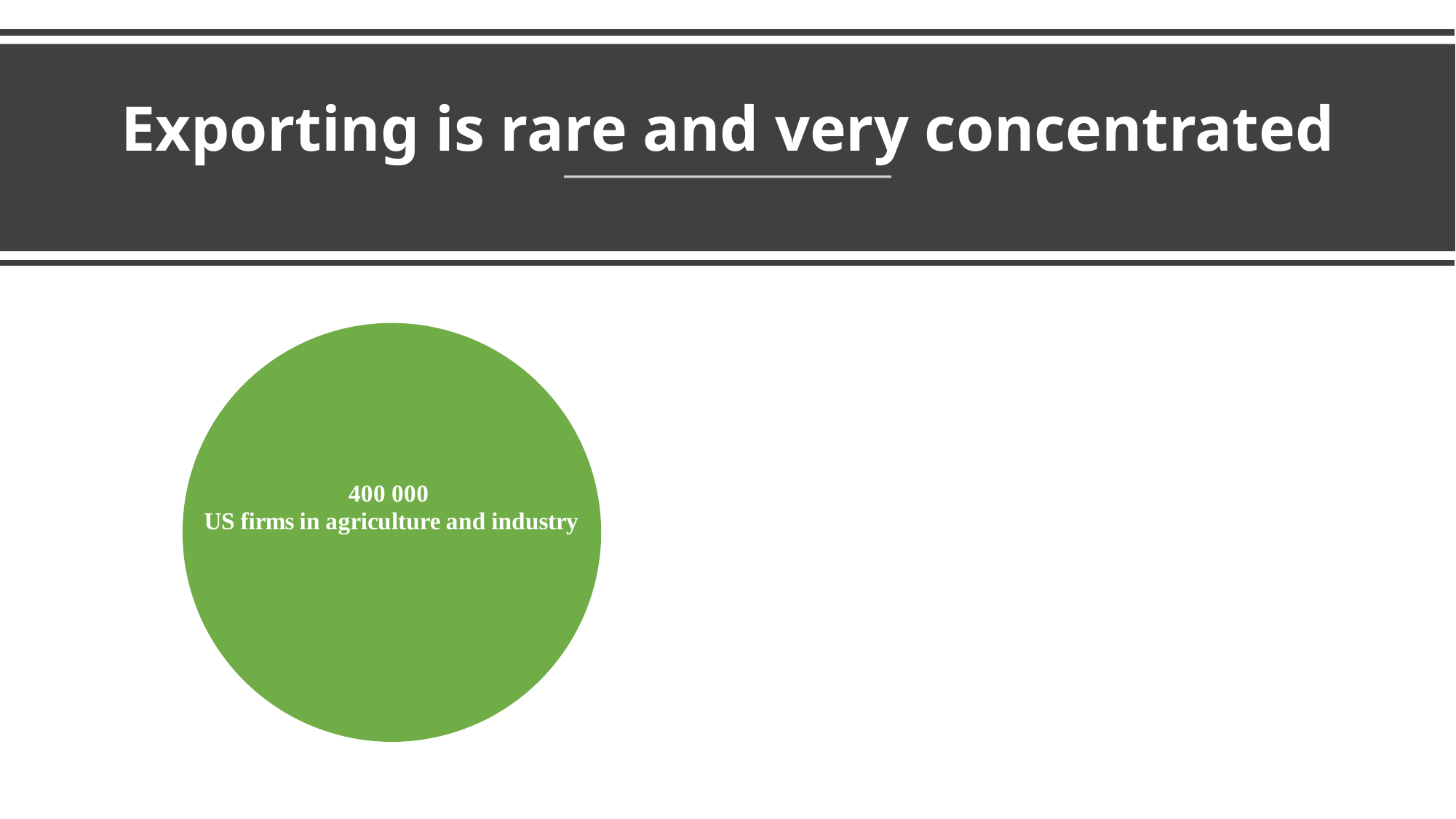
What does the value 400 000 in the green circle represent? US firms in agriculture and industry How many data categories are shown in the circle chart? 1 What is the title of the slide containing the green circle? Exporting is rare and very concentrated Is the value shown in the green circle greater or less than 100 000? greater What number is printed inside the green circle? 400 000 What colour is the circle on the slide? Green